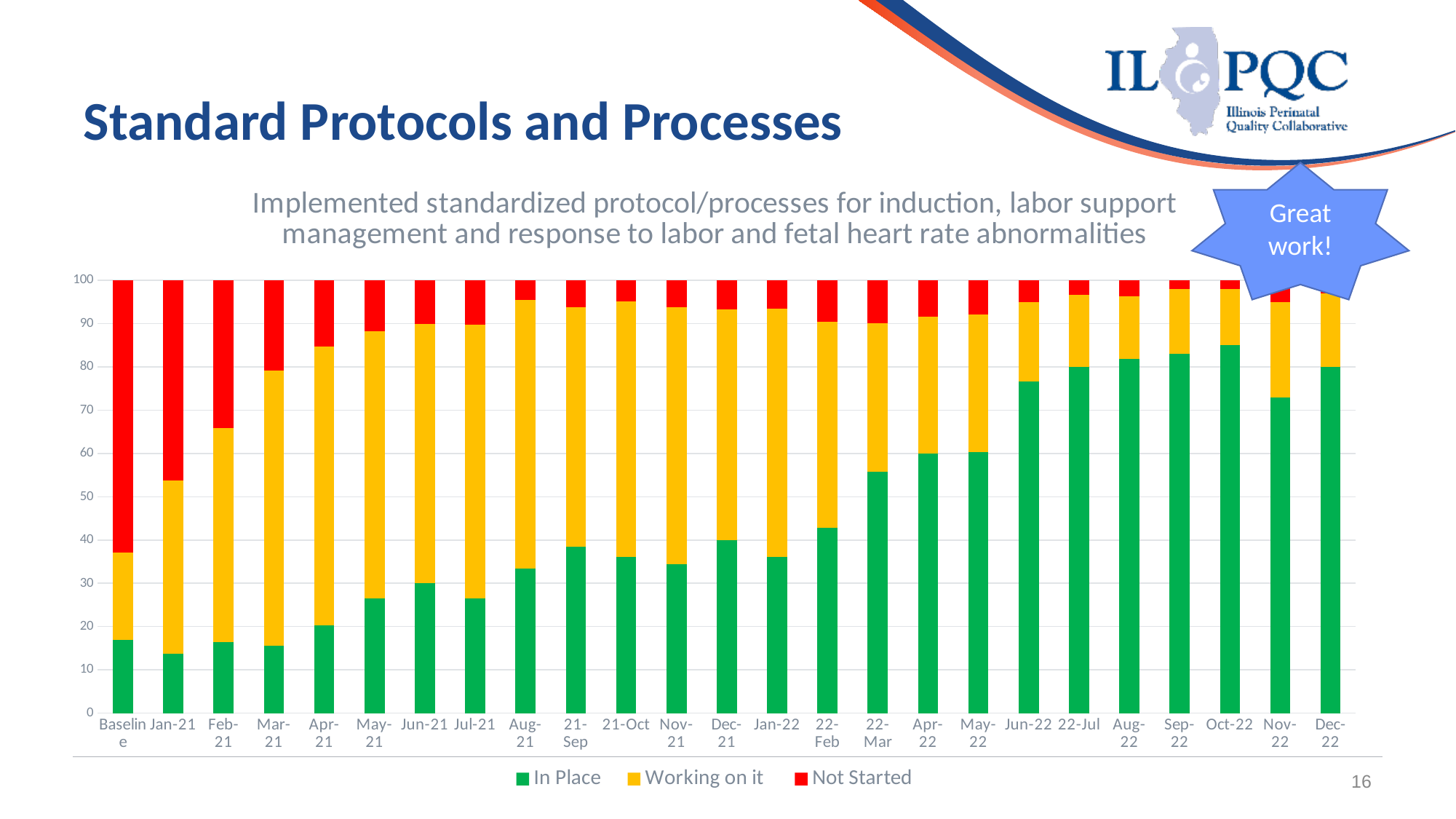
How many series does the legend list? 3 Which category has the largest 'Not Started' segment? Baseline Is the 'In Place' value for Oct-22 greater or less than 80? greater Which is larger, the 'In Place' value for Baseline or for Dec-22? Dec-22 Is the 'In Place' value for Baseline greater or less than 20? less What kind of chart is shown on the slide? Stacked bar chart What are the three series named in the legend? In Place, Working on it, Not Started Does the 'In Place' series generally rise or fall from Baseline to Dec-22? Rise Is the 'In Place' value for 22-Mar greater or less than 50? greater How many categories are shown along the x axis? 25 Which colour represents the 'Not Started' series? Red